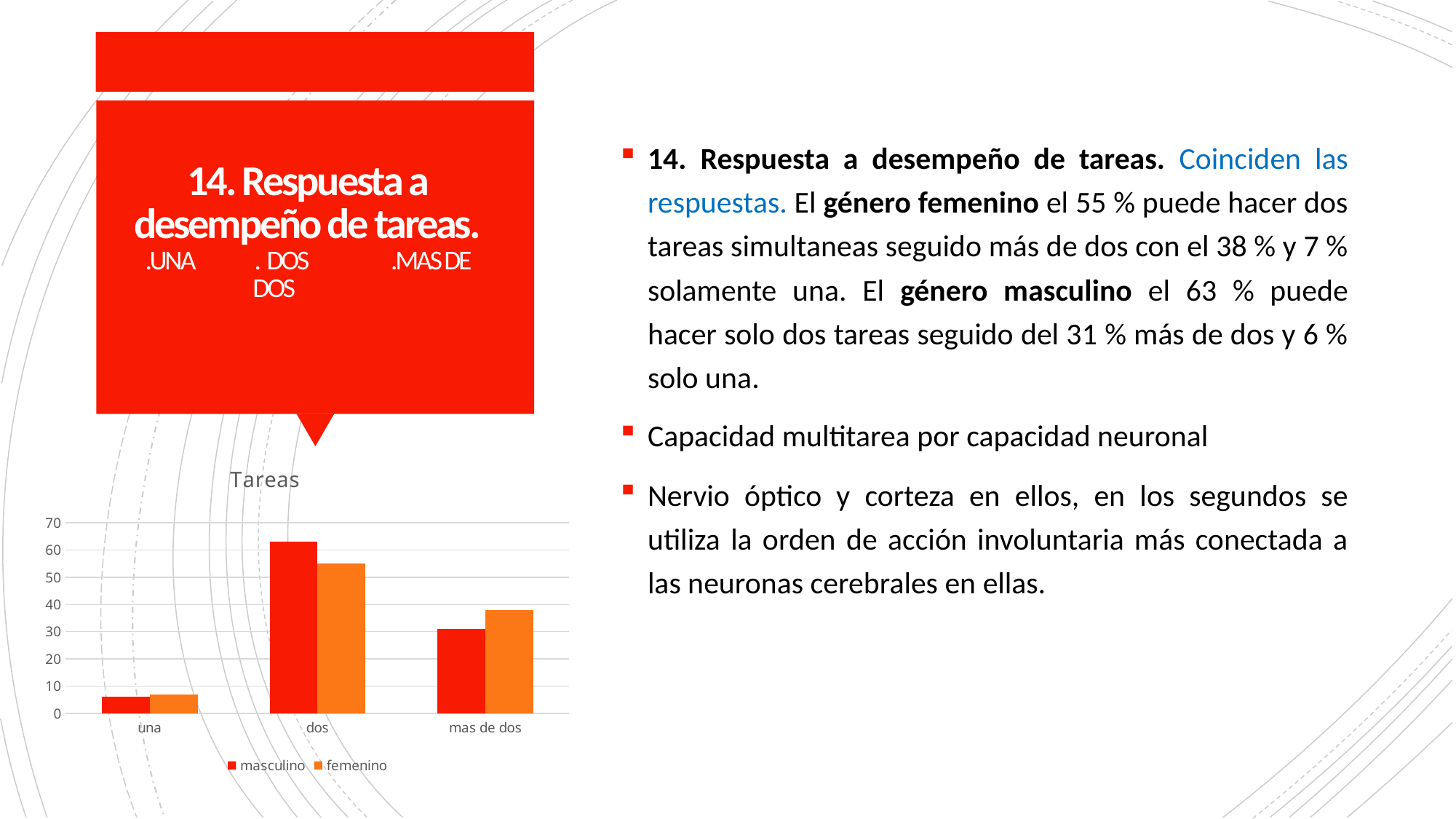
How many categories are shown on the x axis of the chart? 3 What kind of chart is shown on the slide? bar chart Which category has the lowest value for the femenino series? una Is the value for femenino in the category mas de dos greater or less than 30? greater Is the value for masculino in the category una greater or less than 10? less For the category dos, which series has the larger value, masculino or femenino? masculino Which colour represents the femenino series in the chart? orange Which category has the highest value for the masculino series? dos What is the title of the chart? Tareas For the category mas de dos, which series has the larger value, masculino or femenino? femenino How many series does the chart legend list? 2 Is the value for masculino in the category dos greater or less than 60? greater